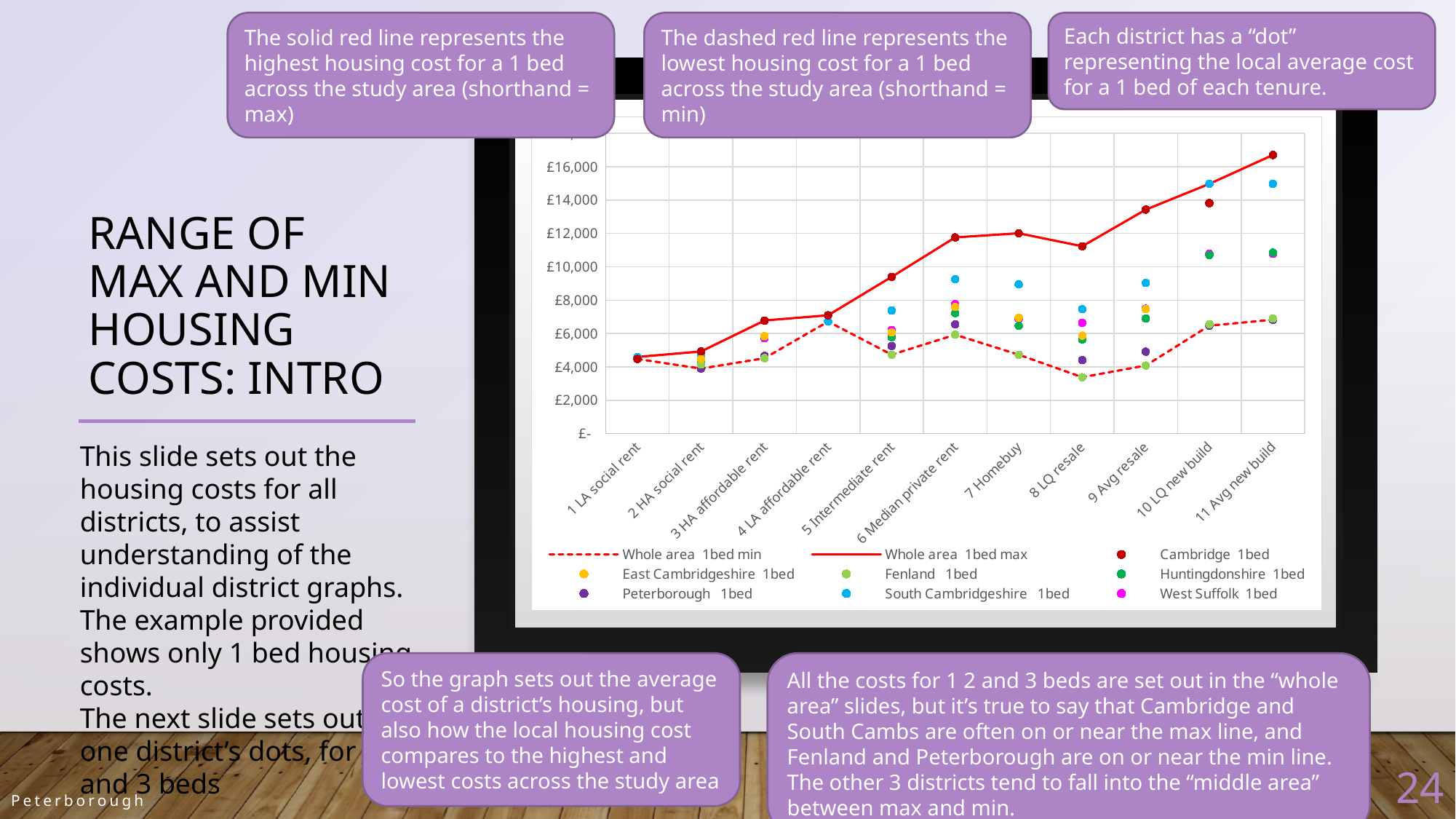
Which is larger for the Whole area 1bed max line: the value at 11 Avg new build or at 10 LQ new build? 11 Avg new build Is the value of the Whole area 1bed max line at 11 Avg new build greater or less than £16,000? greater What kind of chart is shown on the slide? line chart How many categories are shown along the x axis of the chart? 11 Does the Whole area 1bed max line generally rise or fall from left to right across the categories? rise How many series does the chart's legend list? 9 Is the South Cambridgeshire 1bed value at 11 Avg new build greater or less than £14,000? greater For which category does the Whole area 1bed max line reach its highest value? 11 Avg new build Which legend series is drawn as a dashed red line? Whole area 1bed min Is the value of the Whole area 1bed min line at 8 LQ resale greater or less than £4,000? less For which category does the Whole area 1bed min line reach its lowest value? 8 LQ resale